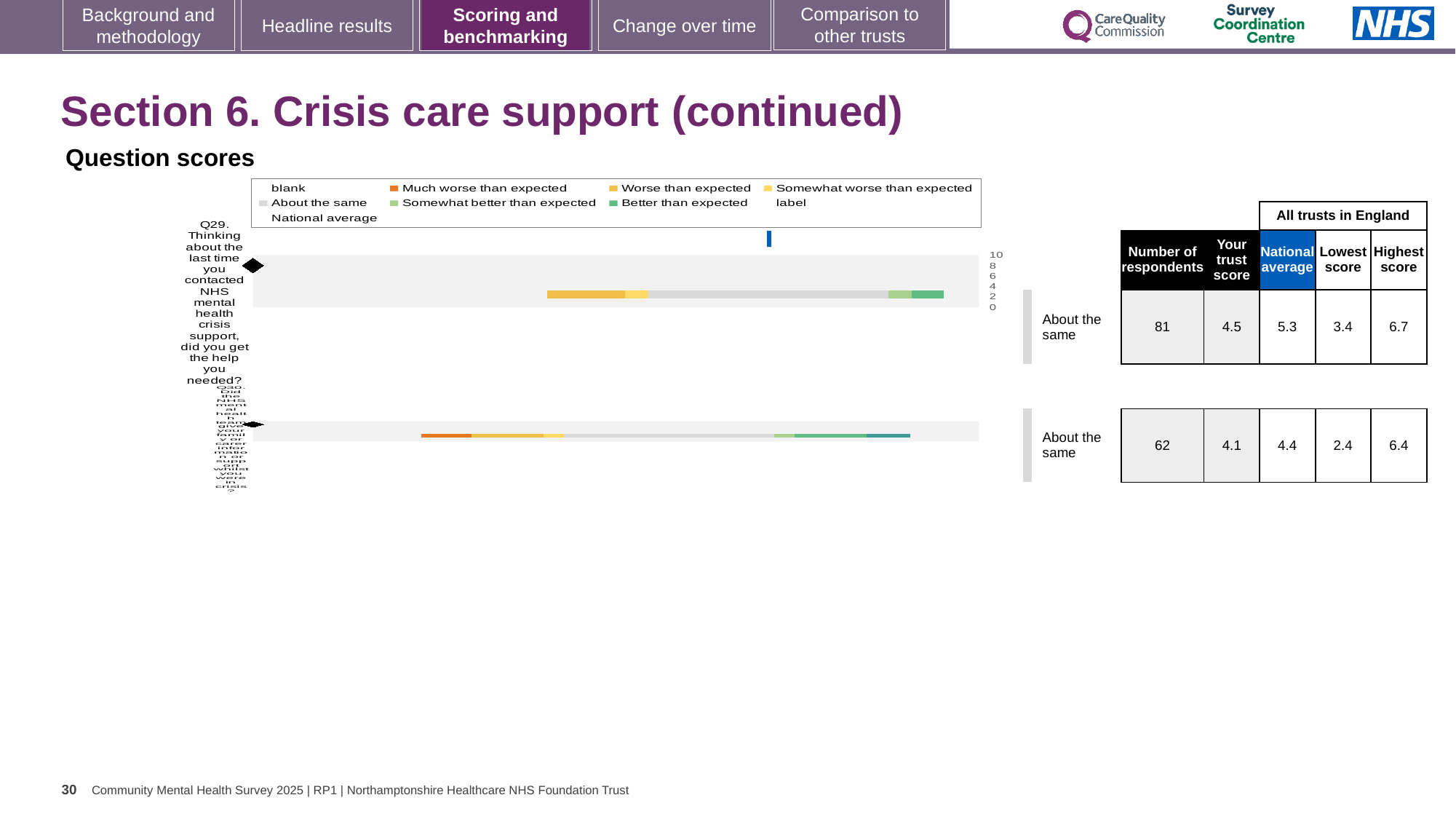
What is the difference between the national average and the trust score for Q29? 0.8 How many respondents answered Q29? 81 What is the trust score for Q29 (Thinking about the last time you contacted NHS mental health crisis support, did you get the help you needed?)? 4.5 How many questions (bars) are plotted in the question scores chart? 2 What is the maximum value shown on the chart's score axis? 10 What is the highest score among all trusts in England for Q29? 6.7 What is the national average for Q29? 5.3 What is the trust score for the second question (Q30)? 4.1 What is the lowest score among all trusts in England for the second question (Q30)? 2.4 Which question has more respondents, Q29 or Q30? Q29 What kind of chart is used to show the question scores on this slide? bar chart What is the benchmark category shown for Q29? About the same